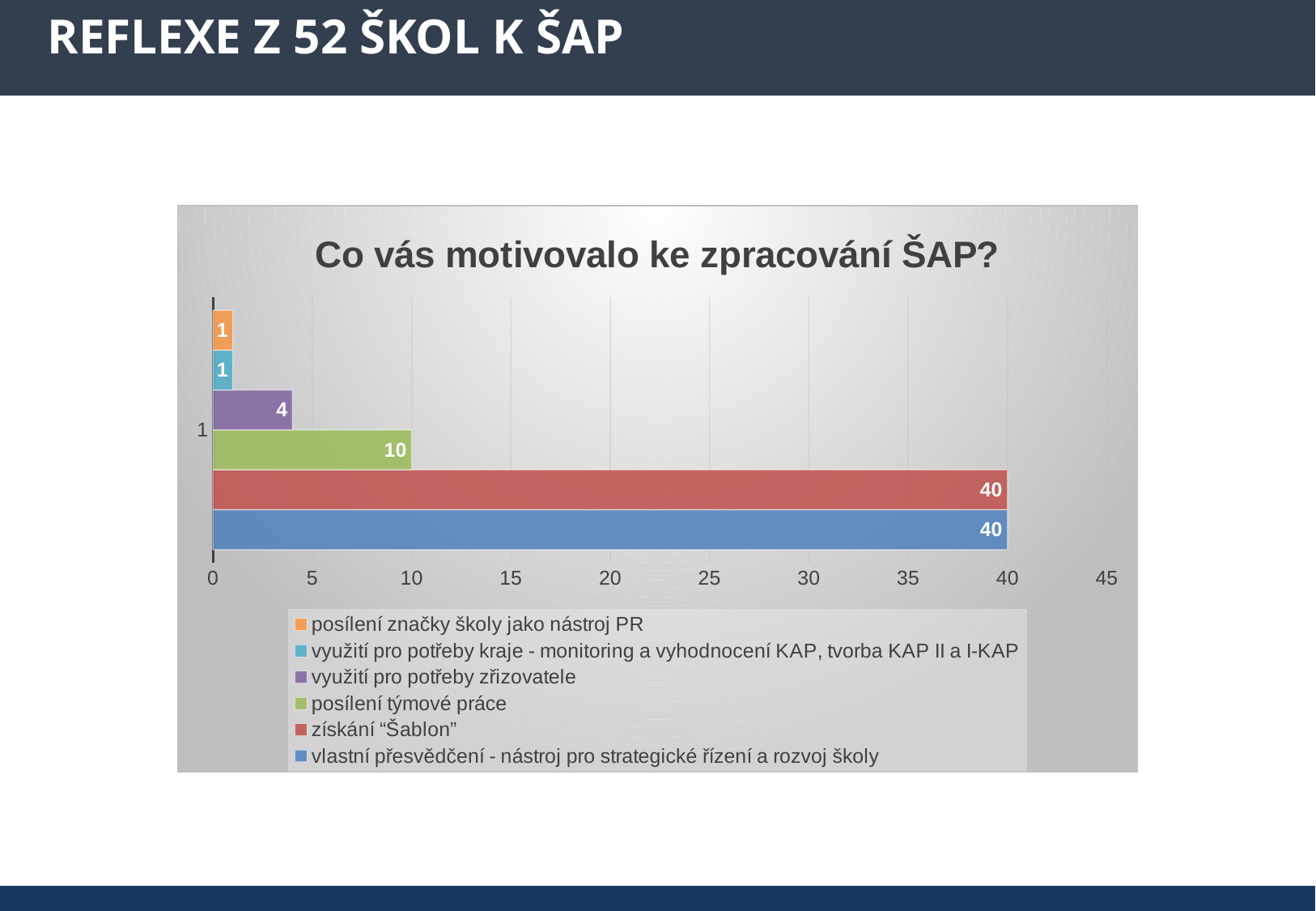
What is the value for "využití pro potřeby zřizovatele"? 4 What is the difference between the value for "posílení týmové práce" and the value for "využití pro potřeby zřizovatele"? 6 What is the value for "získání “Šablon”"? 40 How many series does the legend list? 6 What is the value for "posílení značky školy jako nástroj PR"? 1 What is the value for "vlastní přesvědčení - nástroj pro strategické řízení a rozvoj školy"? 40 What is the title of the chart? Co vás motivovalo ke zpracování ŠAP? What is the value for "posílení týmové práce"? 10 What type of chart is shown on the slide? bar chart Which is larger, the value for "posílení týmové práce" or the value for "využití pro potřeby zřizovatele"? posílení týmové práce Which colour is the bar for "posílení týmové práce"? green What is the difference between the value for "získání “Šablon”" and the value for "posílení týmové práce"? 30